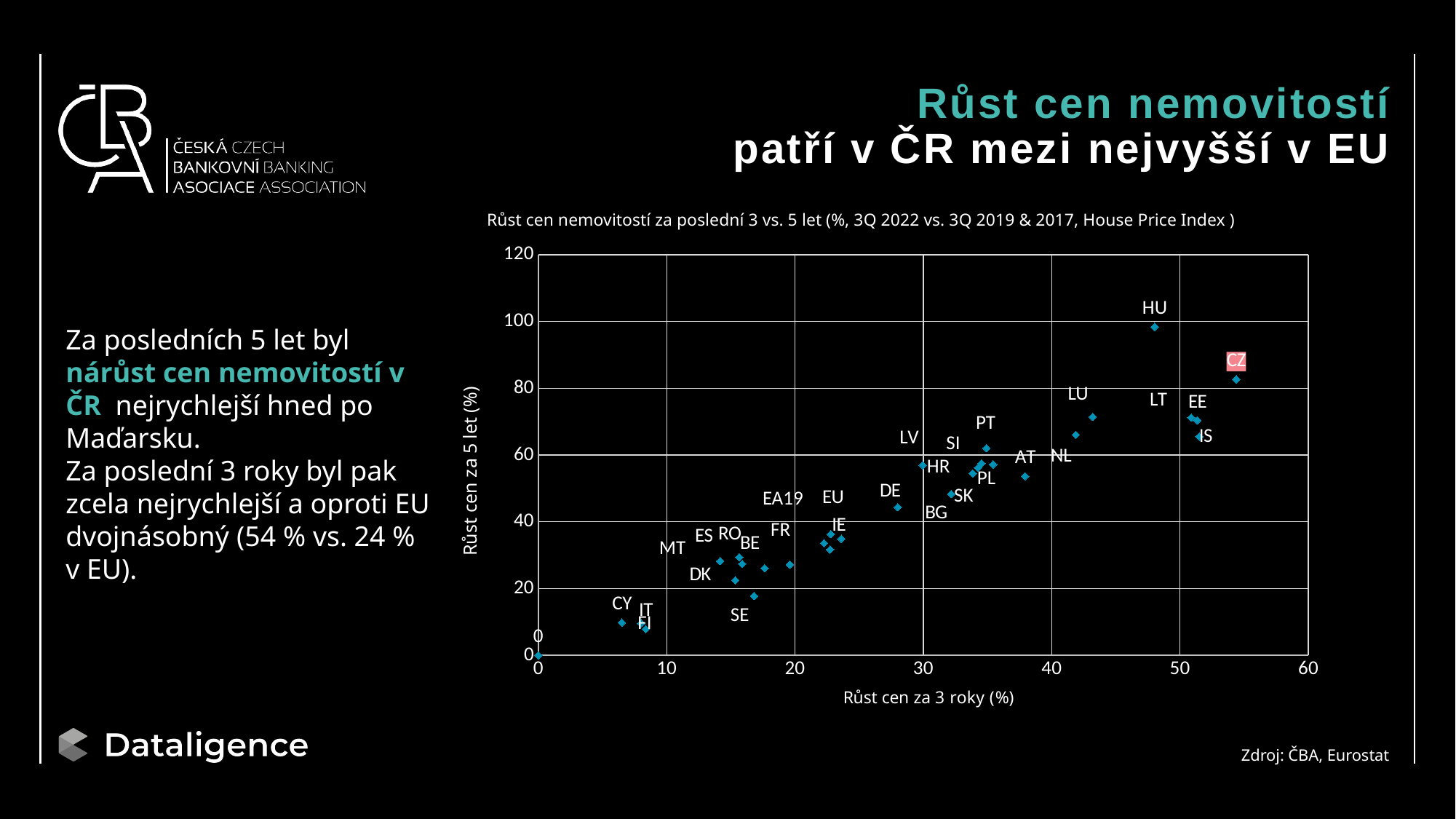
Which has the higher 5-year price growth (vertical axis), LV or DE? LV Is the 5-year price growth (vertical axis) for SE greater or less than 20? less Is the 3-year price growth (horizontal axis) for CZ greater or less than 50? greater Which has the higher 5-year price growth (vertical axis), HU or CZ? HU Which country's label is highlighted with a coloured box in the chart? CZ Which country has the lowest value on the horizontal axis (Růst cen za 3 roky)? CY What kind of chart is shown on the slide? scatter chart Is the 5-year price growth (vertical axis) for HU greater or less than 80? greater What is the title of the horizontal axis of the chart? Růst cen za 3 roky (%) Which country has the highest value on the horizontal axis (Růst cen za 3 roky)? CZ Which country has the highest value on the vertical axis (Růst cen za 5 let)? HU